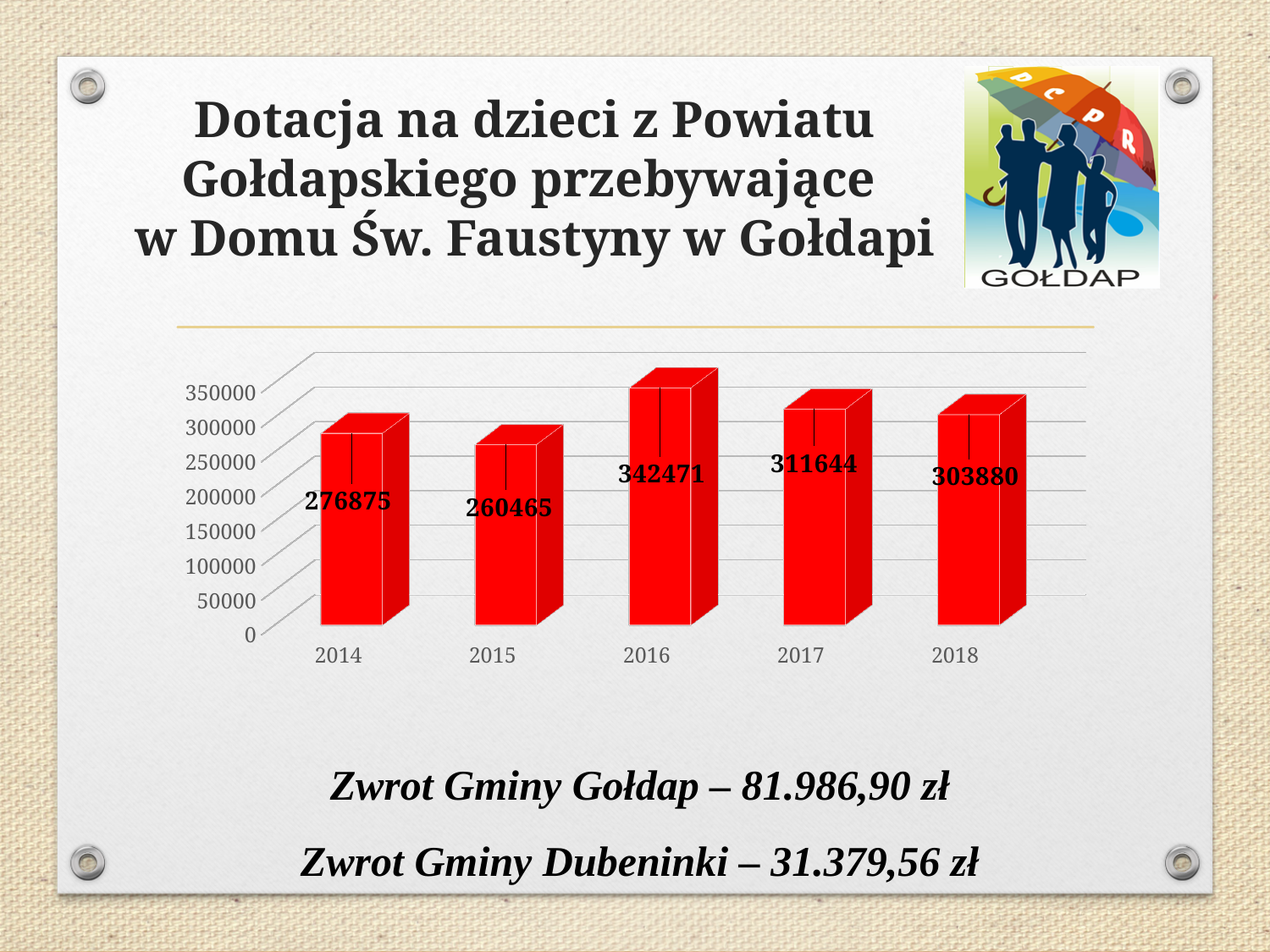
Which year has the highest value? 2016 What is the difference between the values for 2017 and 2018? 7764 How many years are shown on the x axis? 5 Is the value for 2015 greater or less than 300000? less What is the value for 2014? 276875 Do the values rise or fall from 2016 to 2018? fall Which year has the lowest value? 2015 What is the difference between the values for 2016 and 2015? 82006 What is the value for 2016? 342471 What kind of chart is shown on the slide? bar chart Which is larger, the value for 2014 or the value for 2015? 2014 What is the value for 2018? 303880